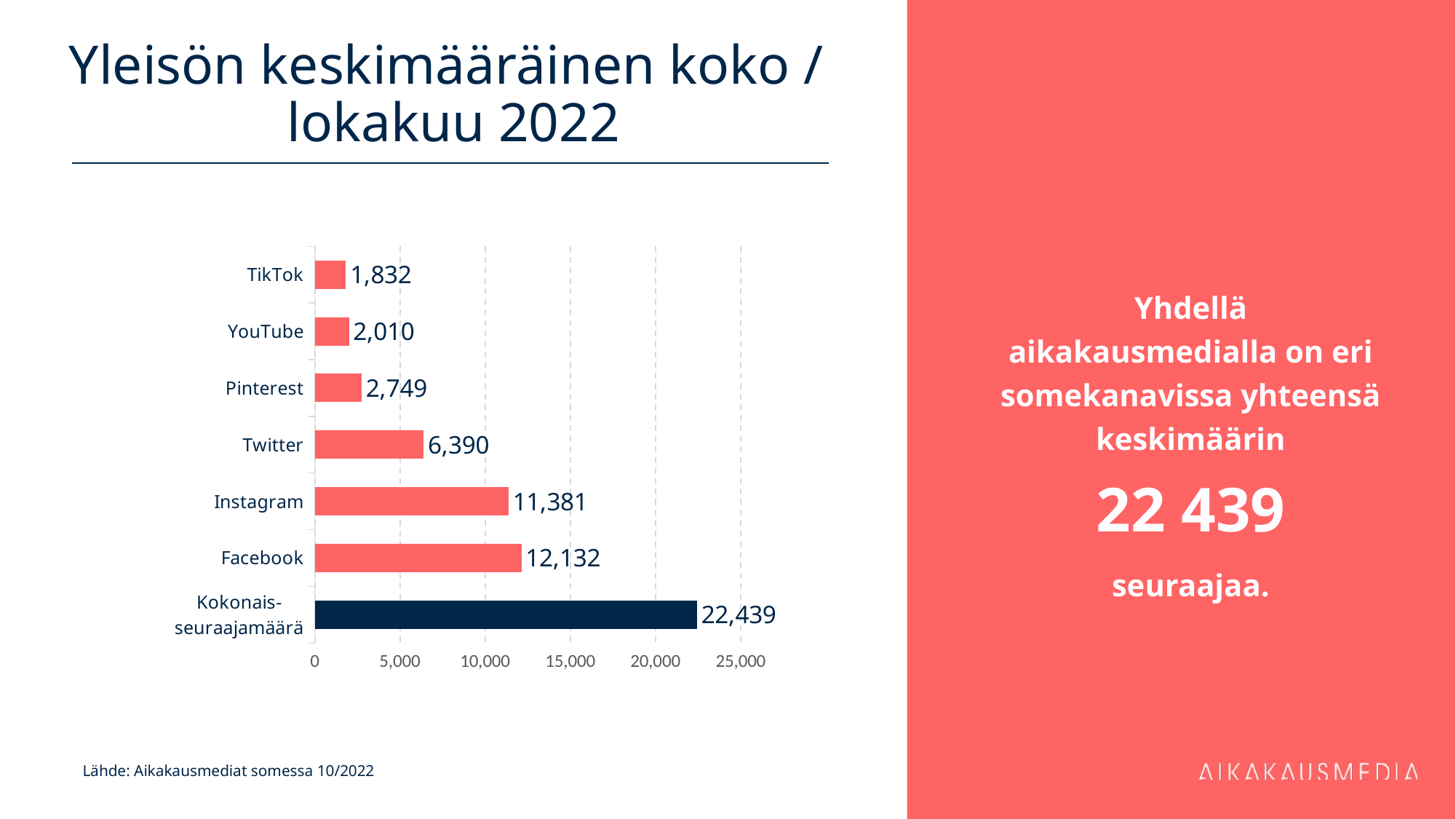
What is the title of the slide? Yleisön keskimääräinen koko / lokakuu 2022 Which is larger, the value for Pinterest or the value for YouTube? Pinterest What is the value for Facebook? 12,132 Which category has the highest value? Kokonais-seuraajamäärä What is the difference between the values for Facebook and Instagram? 751 Which category has the lowest value? TikTok What kind of chart is shown on the slide? bar chart What is the value for Kokonais-seuraajamäärä? 22,439 What is the value for Twitter? 6,390 Is the value for Instagram greater or less than 10,000? greater What is the value for TikTok? 1,832 How many categories are shown in the chart? 7